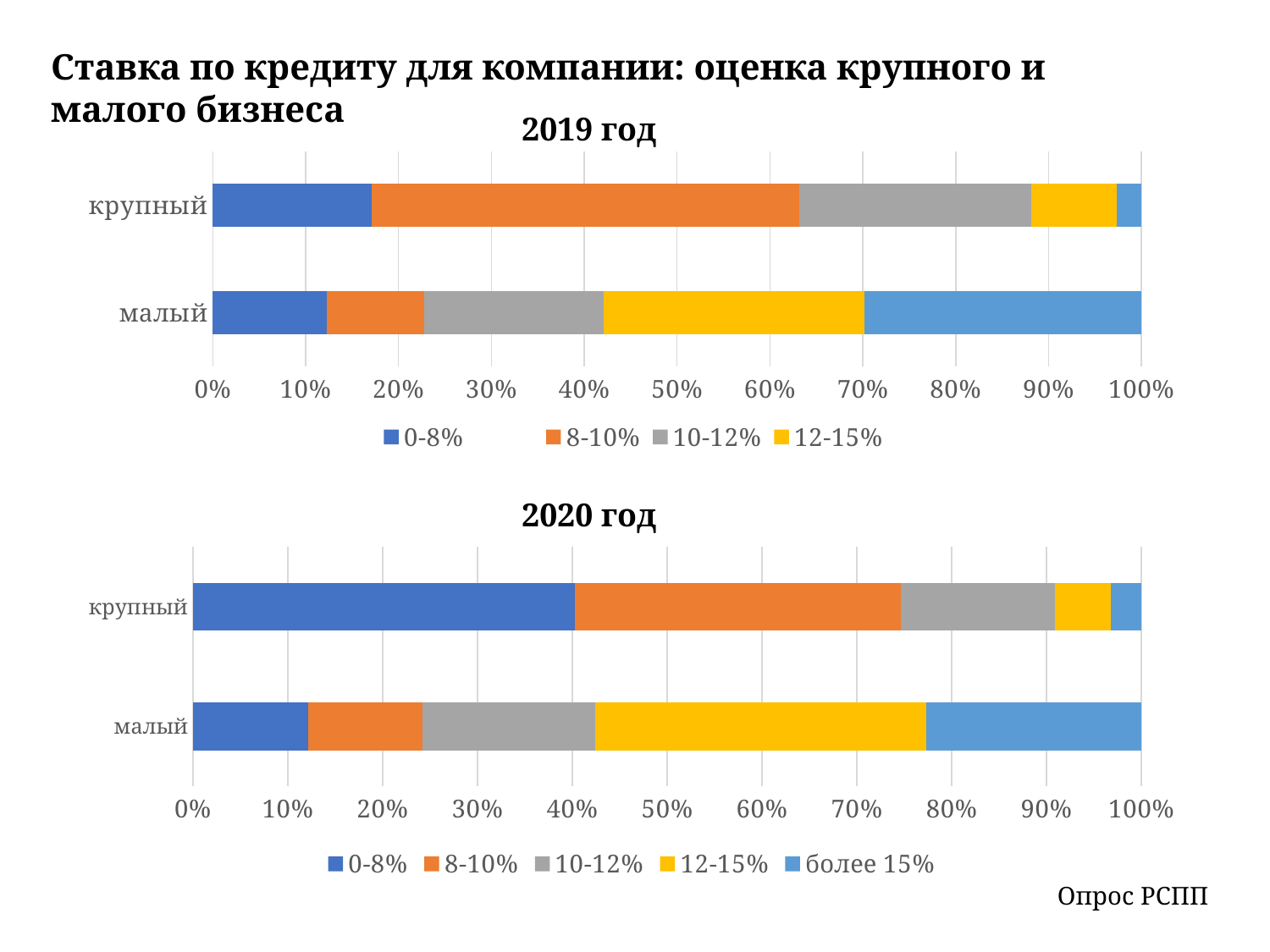
In the "2019 год" chart, is the 8-10% segment for крупный greater or less than 40%? greater What kind of chart is the "2019 год" chart? bar chart In the "2020 год" chart, which category has the larger 0-8% segment, крупный or малый? крупный In the "2020 год" chart, is the 0-8% segment for крупный greater or less than 30%? greater In the "2019 год" chart, is the 0-8% segment for крупный greater or less than 20%? less In the "2020 год" chart, which category has the larger 12-15% segment, крупный or малый? малый In the "2019 год" chart, which series forms the largest segment of the крупный bar? 8-10% In the "2020 год" chart, which series forms the largest segment of the малый bar? 12-15% What is the title of the upper chart on the slide? 2019 год How many series does the legend of the "2020 год" chart list? 5 How many categories are shown on the y axis of the "2020 год" chart? 2 How many series does the legend of the "2019 год" chart list? 4